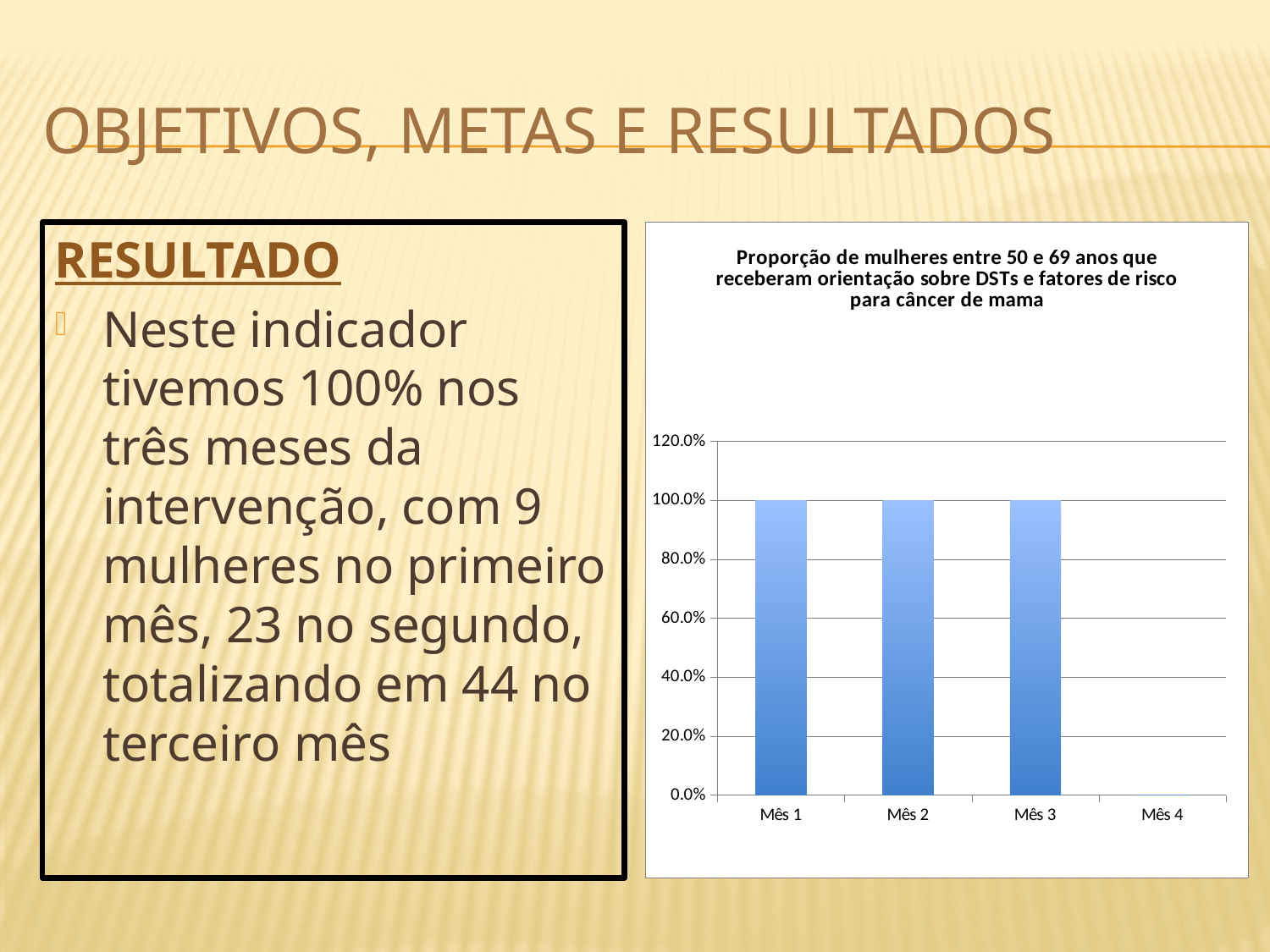
What is the difference between the values for Mês 1 and Mês 3? 0.0% What is the value for Mês 2? 100.0% How many categories are shown on the x axis of the chart? 4 What is the title of the chart? Proporção de mulheres entre 50 e 69 anos que receberam orientação sobre DSTs e fatores de risco para câncer de mama Which is larger, the value for Mês 1 or the value for Mês 4? Mês 1 Is the value for Mês 3 greater or less than 120.0%? less What is the value for Mês 1? 100.0% What is the value for Mês 3? 100.0% Do the values rise, fall or stay the same from Mês 1 to Mês 3? stay the same Is the value for Mês 2 greater or less than 80.0%? greater Which category has the lowest value in the chart? Mês 4 What kind of chart is shown on the slide? bar chart